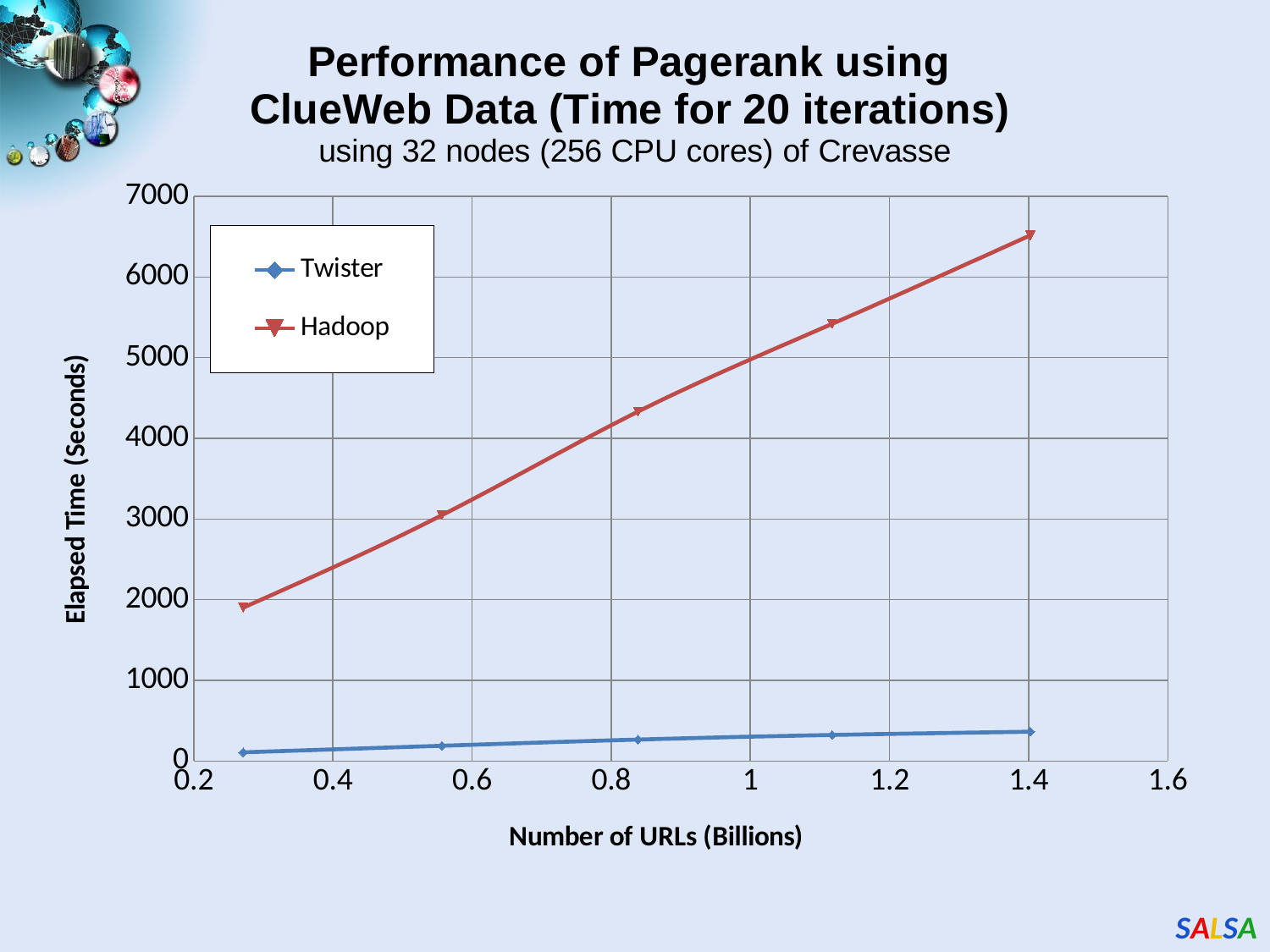
Does the elapsed time for Hadoop rise or fall as the number of URLs increases? rise Does the elapsed time for Twister rise or fall as the number of URLs increases? rise Which two series are listed in the legend? Twister and Hadoop Which series has the lower elapsed time across all numbers of URLs? Twister Is the elapsed time for Hadoop at about 0.84 billion URLs greater or less than 4000 seconds? greater Is the elapsed time for Hadoop at 1.4 billion URLs greater or less than 6000 seconds? greater What is the label of the x axis? Number of URLs (Billions) What kind of chart is shown on the slide? line chart How many series does the legend list? 2 How many data points are plotted for the Hadoop series? 5 Is the elapsed time for Twister at 1.4 billion URLs greater or less than 1000 seconds? less Which series has the higher elapsed time at 1.4 billion URLs, Twister or Hadoop? Hadoop